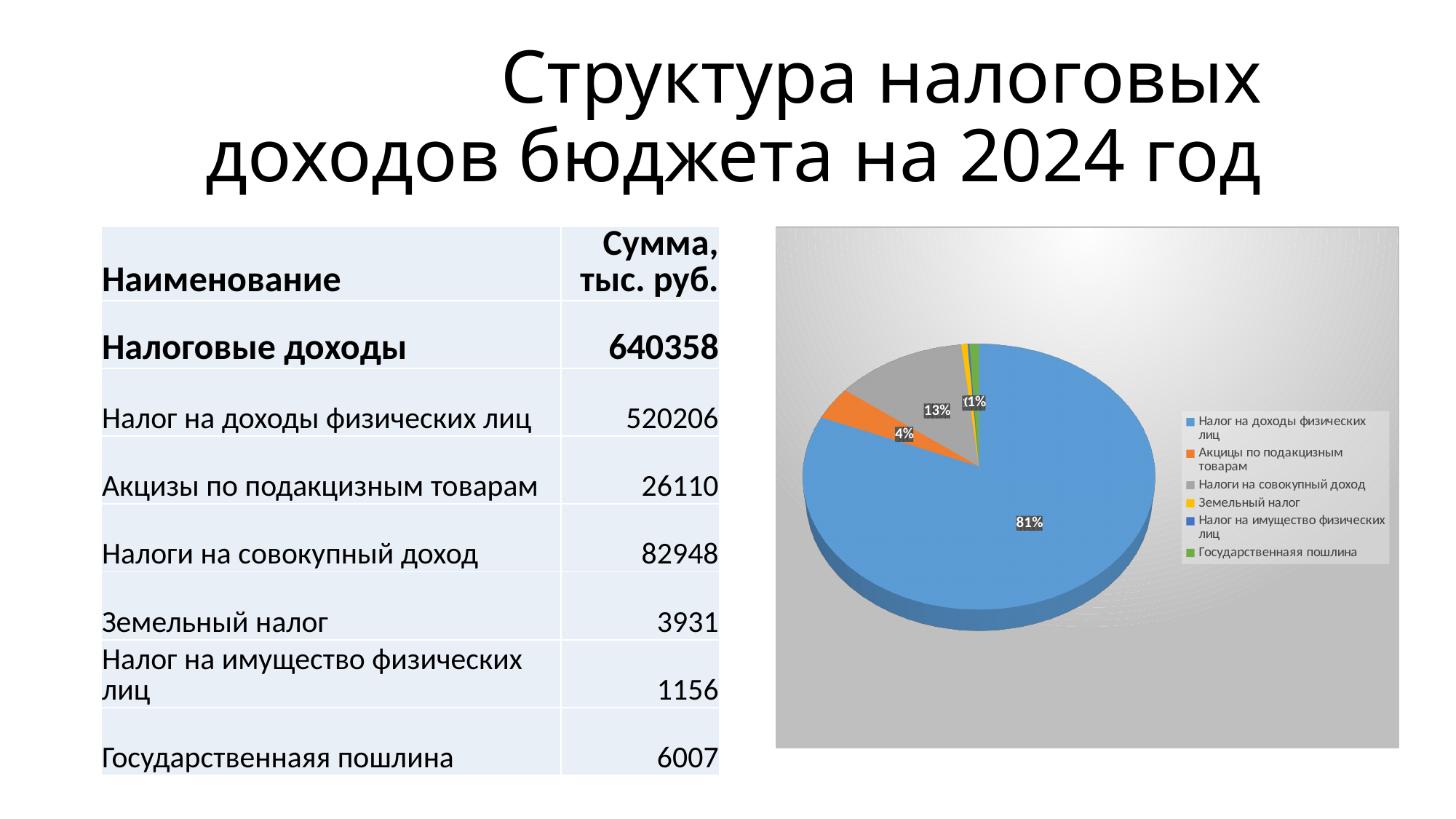
Which category has the largest slice of the pie? Налог на доходы физических лиц What share of the pie does 'Налог на доходы физических лиц' take? 81% Which slice is larger: 'Налоги на совокупный доход' or 'Акцизы по подакцизным товарам'? Налоги на совокупный доход Is the share of 'Налог на доходы физических лиц' greater or less than 50%? greater What share of the pie does 'Налоги на совокупный доход' take? 13% What share of the pie does 'Акцизы по подакцизным товарам' take? 4% What is the difference in percentage points between the 'Налог на доходы физических лиц' slice and the 'Налоги на совокупный доход' slice? 68 What colour is the slice for 'Налог на доходы физических лиц'? blue What kind of chart is shown on the slide? pie chart How many entries does the legend of the pie chart list? 6 What colour is the slice for 'Акцизы по подакцизным товарам'? orange